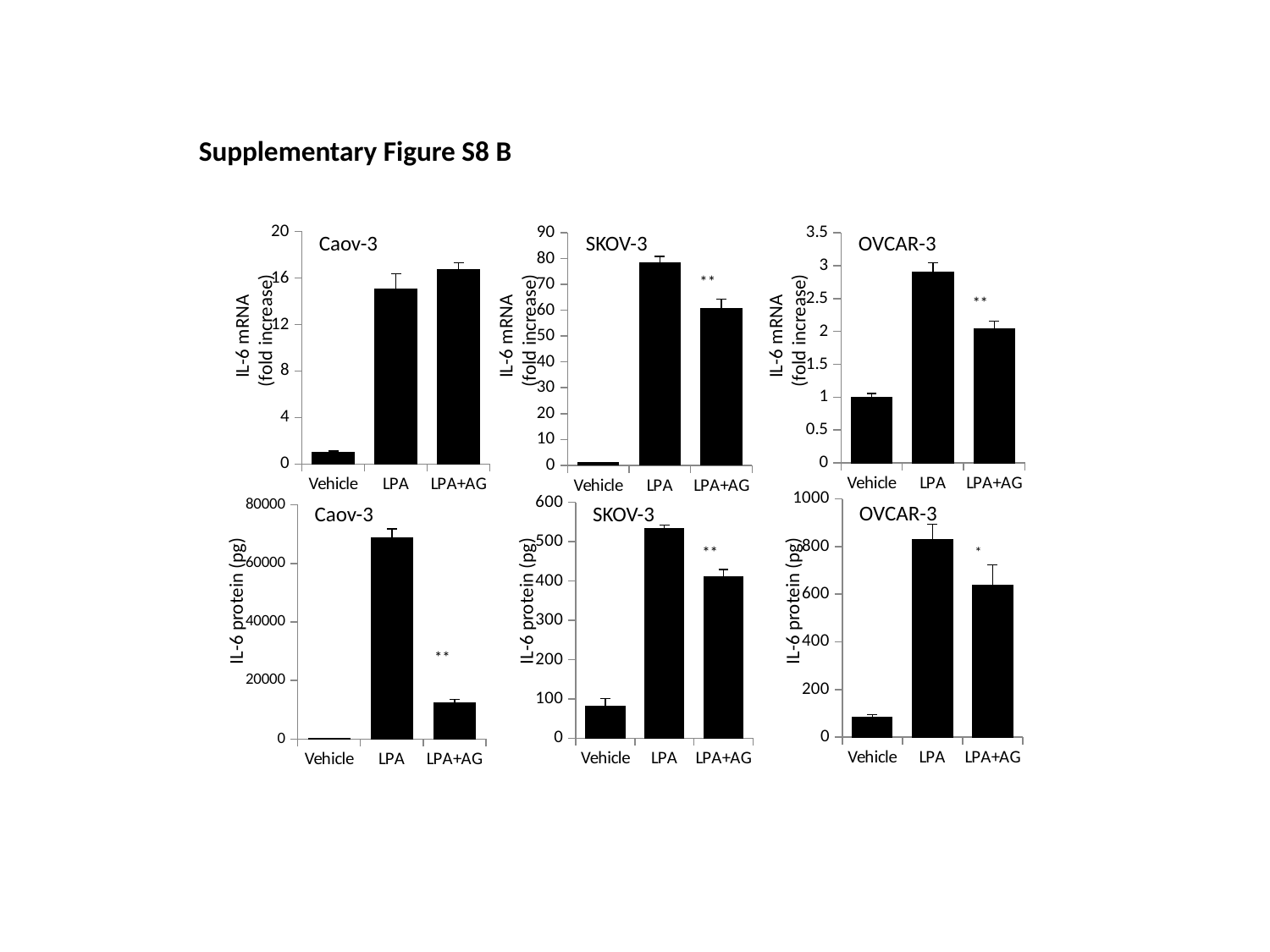
In the top-right chart (OVCAR-3, IL-6 mRNA), is the value for LPA greater or less than 2.5? greater In the top-middle chart (SKOV-3, IL-6 mRNA), which category has the highest value? LPA In the bottom-right chart (OVCAR-3, IL-6 protein), is the value for Vehicle greater or less than 200? less In the bottom-right chart (OVCAR-3, IL-6 protein), which category has the highest value? LPA In the top-left chart (Caov-3, IL-6 mRNA), which category has the lowest value? Vehicle In the bottom-middle chart (SKOV-3, IL-6 protein), is the value for LPA greater or less than 500? greater What kind of chart is the top-left chart (Caov-3, IL-6 mRNA)? bar chart How many categories are shown on the x axis of the bottom-left chart (Caov-3, IL-6 protein)? 3 In the top-right chart (OVCAR-3, IL-6 mRNA), which is larger, the value for LPA or the value for LPA+AG? LPA